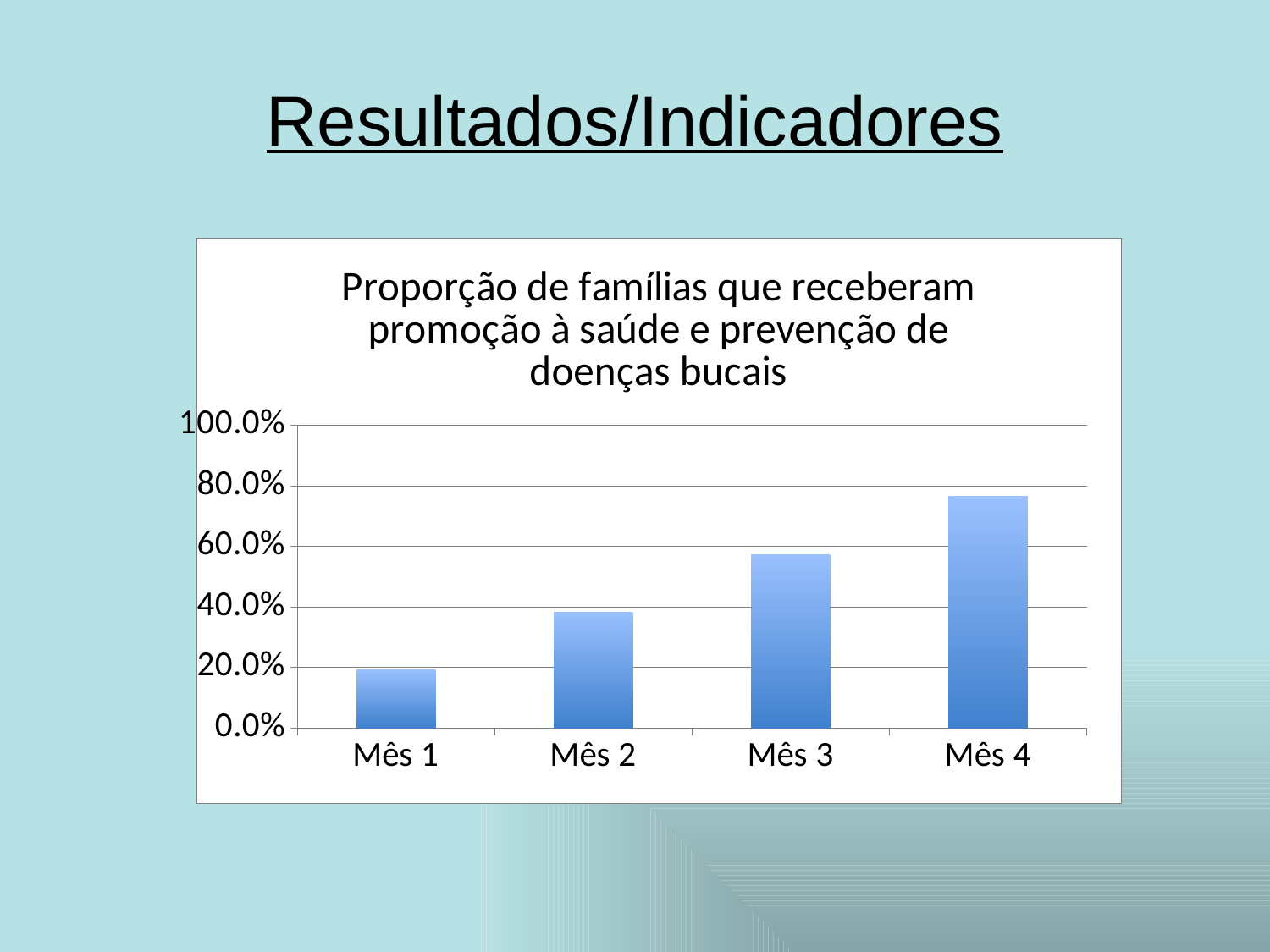
Which is larger, the value for Mês 2 or the value for Mês 3? Mês 3 Which month has the lowest proportion of families in the chart? Mês 1 Which month has the highest proportion of families in the chart? Mês 4 How many categories (months) are shown on the x axis of the chart? 4 What kind of chart is shown on the slide? bar chart Do the values rise or fall from Mês 1 to Mês 4? rise Is the value for Mês 4 greater or less than 60.0%? greater Is the value for Mês 3 greater or less than 80.0%? less What is the highest value shown on the y axis of the chart? 100.0% Is the value for Mês 2 greater or less than 20.0%? greater What is the title of the chart? Proporção de famílias que receberam promoção à saúde e prevenção de doenças bucais